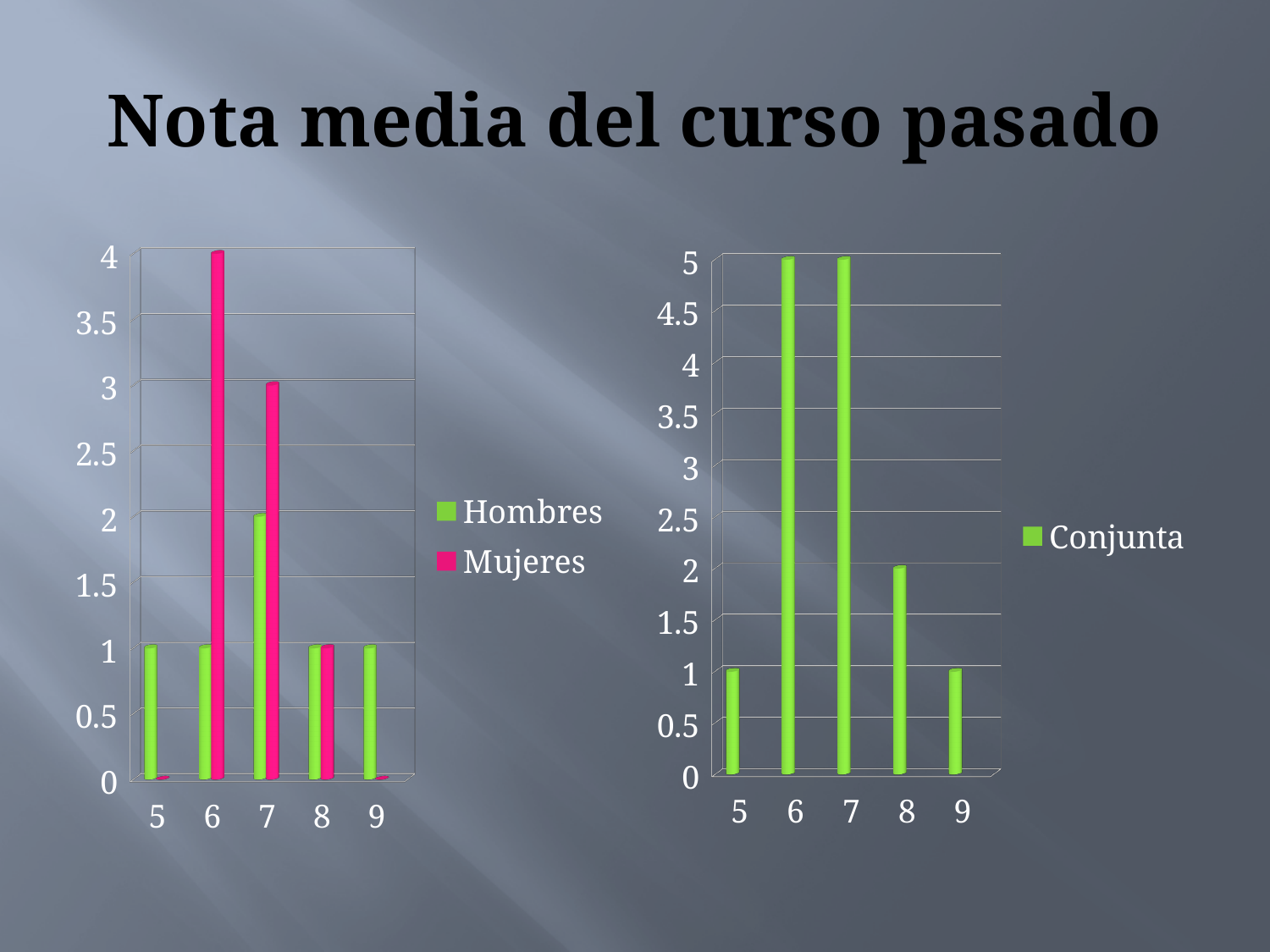
On the left chart, what is the Mujeres value for category 6? 4 On the right chart, which category has the lowest Conjunta value? 5 and 9 On the left chart, which category has the highest Mujeres value? 6 On the right chart, what is the Conjunta value for category 8? 2 What kind of chart is the right chart? Bar chart On the left chart, what is the Hombres value for category 7? 2 How many categories are shown on the x axis of the right chart? 5 On the left chart, what is the difference between the Mujeres value and the Hombres value for category 6? 3 How many series does the legend of the left chart list? 2 On the left chart, which category has the highest Hombres value? 7 On the left chart, for category 7, which series is larger, Hombres or Mujeres? Mujeres What is the title of the slide? Nota media del curso pasado